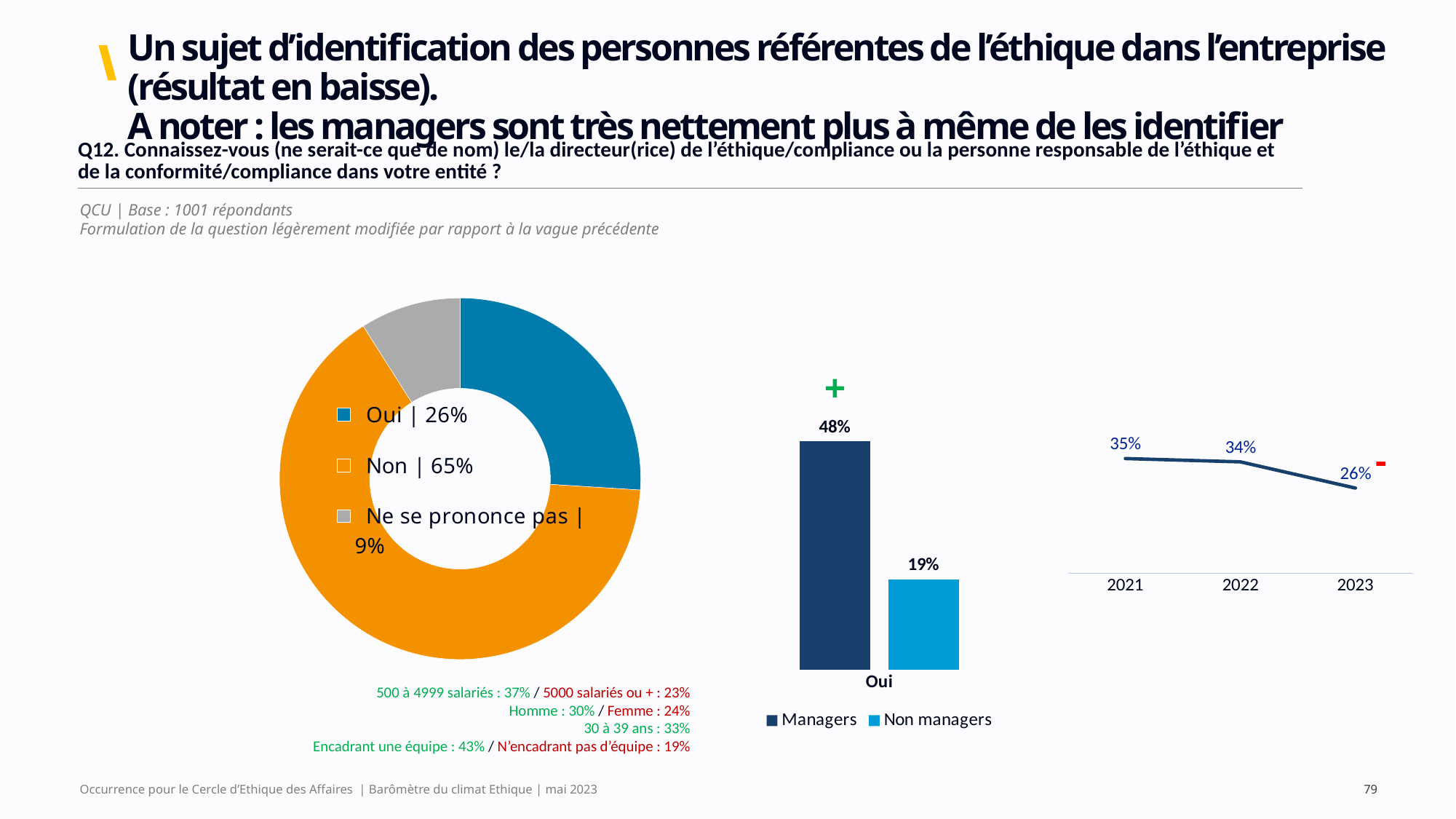
In the donut chart on the left, what share is "Ne se prononce pas"? 9% In the bar chart in the middle, how many series does the legend list? 2 In the donut chart on the left, which category has the largest share? Non In the donut chart on the left, how many categories are shown? 3 In the line chart on the right, what is the value for 2021? 35% In the donut chart on the left, what share of respondents answered "Non"? 65% In the donut chart on the left, which category has the smallest share? Ne se prononce pas In the bar chart in the middle, what is the value for Managers? 48% In the donut chart on the left, what share of respondents answered "Oui"? 26% In the bar chart in the middle, what is the value for Non managers? 19% In the bar chart in the middle, what is the difference between the Managers and Non managers values? 29 percentage points In the line chart on the right, do the values rise or fall from 2021 to 2023? fall